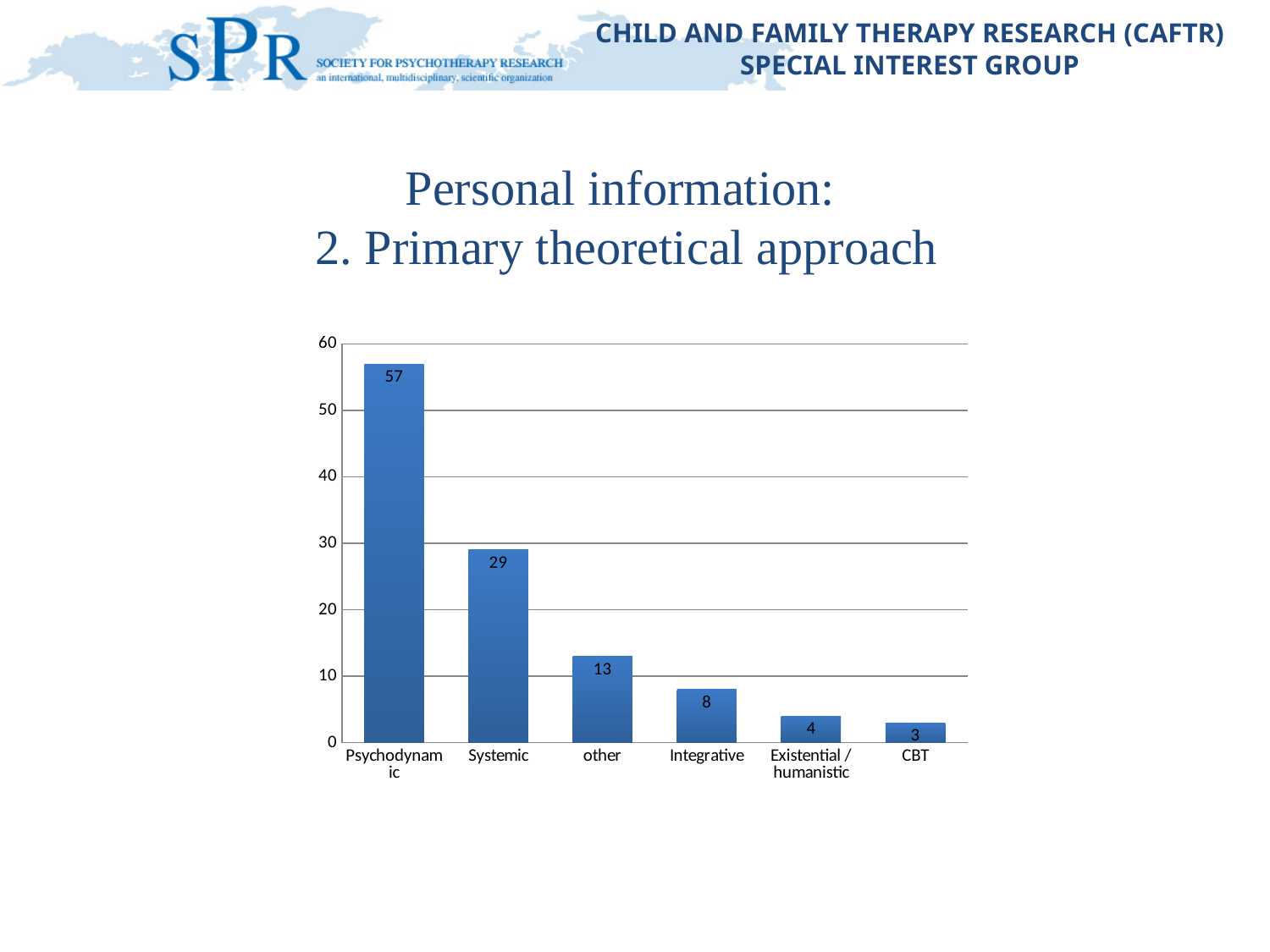
Do the values rise or fall from left to right along the x axis? Fall Which category has the lowest value? CBT How many categories are shown on the x axis? 6 What kind of chart is shown on the slide? Bar chart Which is larger, the value for Integrative or the value for Existential / humanistic? Integrative What is the value for CBT? 3 What is the difference between the values for Psychodynamic and Systemic? 28 What is the value for Psychodynamic? 57 Which category has the highest value? Psychodynamic What is the value for Systemic? 29 What is the value for Integrative? 8 What is the difference between the values for other and Existential / humanistic? 9